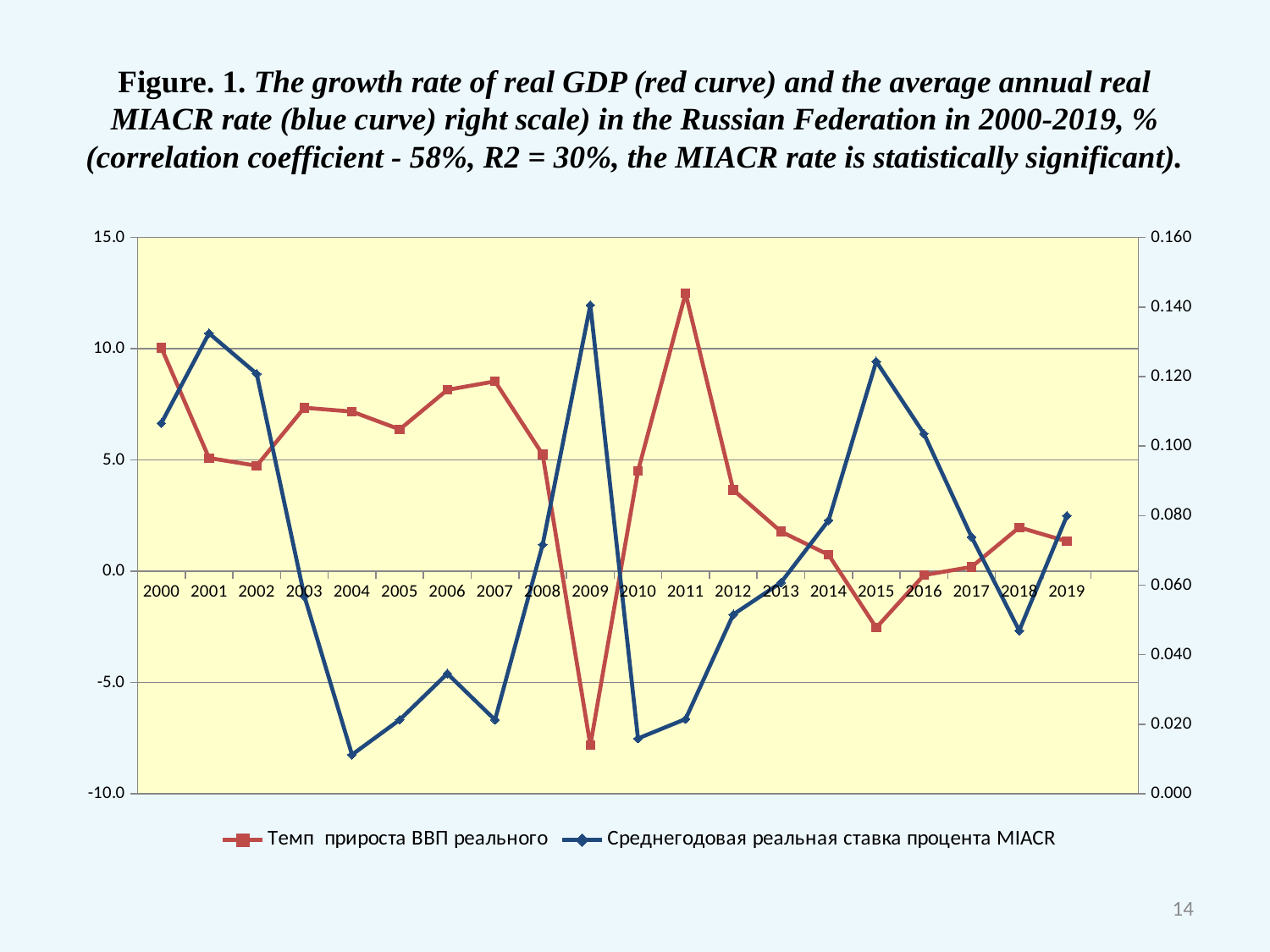
In which year does the red curve (real GDP growth rate) reach its lowest value? 2009 In which year does the blue curve (average annual real MIACR rate) reach its highest value? 2009 Which colour is used for the MIACR rate series? blue In which year does the blue curve (average annual real MIACR rate) reach its lowest value? 2004 Which year has the higher value on the red curve, 2007 or 2013? 2007 Does the red curve rise or fall between 2011 and 2015? fall How many years are plotted along the x axis? 20 In which year does the red curve (real GDP growth rate) reach its highest value? 2011 Is the red curve's value for 2000 greater or less than 5.0? greater How many series does the legend list? 2 Is the blue curve's value for 2015 greater or less than 0.100 on the right scale? greater What kind of chart is shown on the slide? line chart